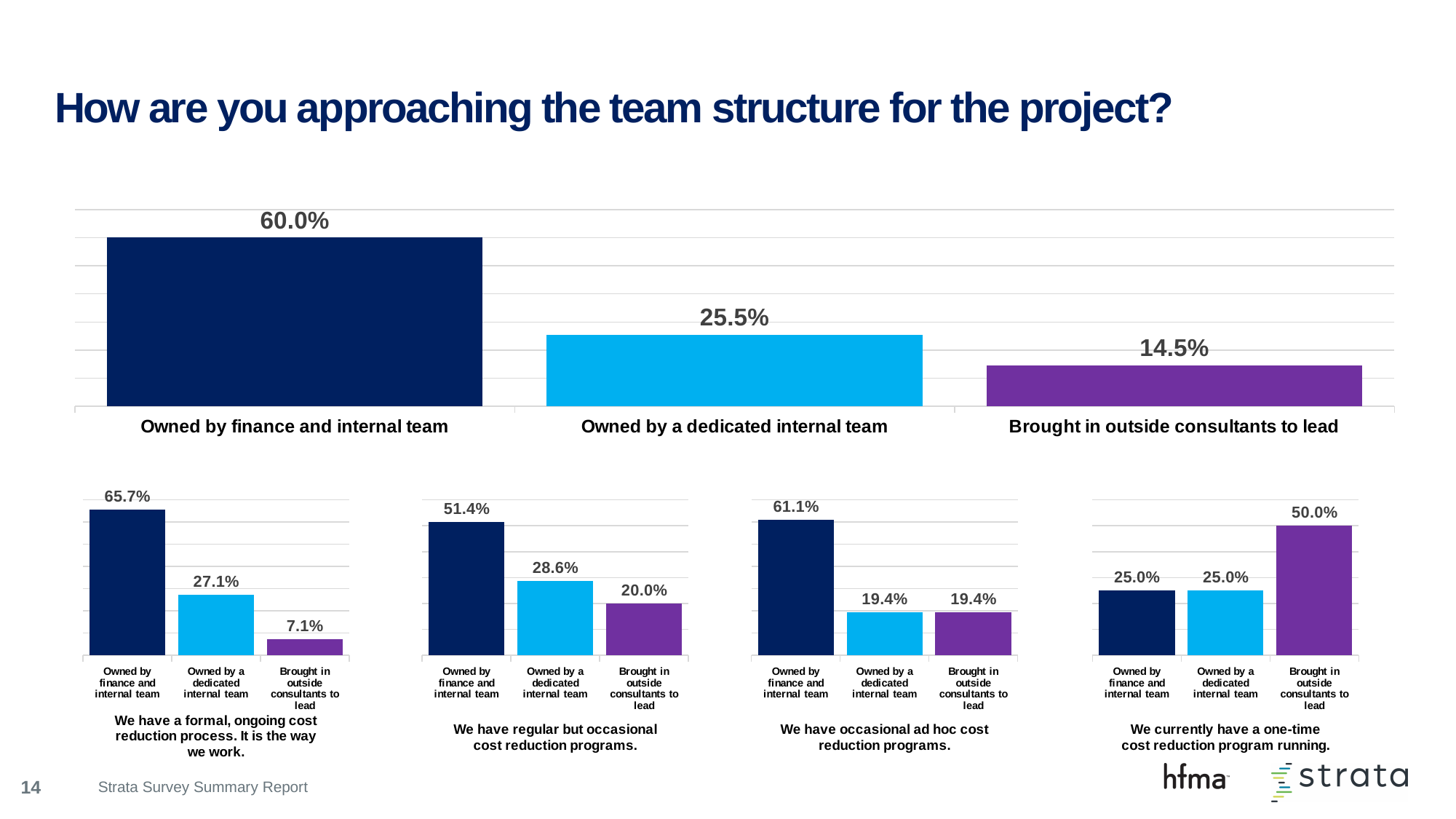
In the bottom chart captioned 'We currently have a one-time cost reduction program running.', what is the value for 'Brought in outside consultants to lead'? 50.0% How many small charts are shown in the bottom row of the slide? 4 In the large top chart, what is the value for 'Owned by finance and internal team'? 60.0% What kind of chart is the large top chart? Bar chart In the large top chart, what is the difference between 'Owned by finance and internal team' and 'Owned by a dedicated internal team'? 34.5% In the bottom chart captioned 'We have regular but occasional cost reduction programs.', what is the difference between 'Owned by finance and internal team' and 'Brought in outside consultants to lead'? 31.4% In the bottom chart captioned 'We have regular but occasional cost reduction programs.', what is the value for 'Owned by a dedicated internal team'? 28.6% In the bottom chart captioned 'We currently have a one-time cost reduction program running.', which is larger: 'Owned by finance and internal team' or 'Brought in outside consultants to lead'? Brought in outside consultants to lead In the bottom chart captioned 'We have a formal, ongoing cost reduction process. It is the way we work.', what is the value for 'Brought in outside consultants to lead'? 7.1% In the large top chart, which category has the lowest value? Brought in outside consultants to lead In the bottom chart captioned 'We have occasional ad hoc cost reduction programs.', which category has the highest value? Owned by finance and internal team In the large top chart, how many categories are shown? 3